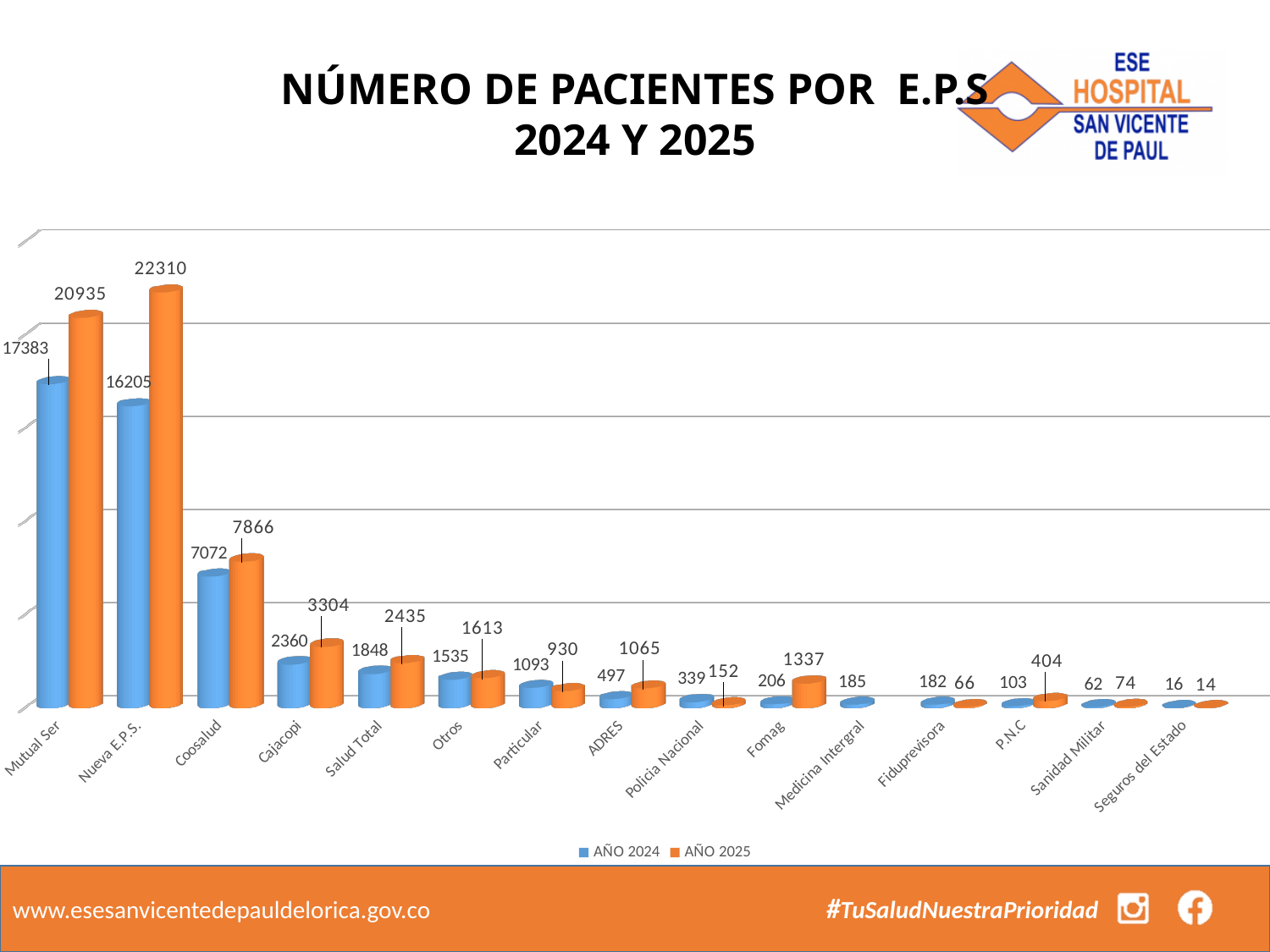
Which category has the highest value in the AÑO 2024 series? Mutual Ser What is the value for Nueva E.P.S. in the AÑO 2025 series? 22310 Which category has the lowest value in the AÑO 2025 series? Seguros del Estado What is the value for P.N.C in the AÑO 2025 series? 404 Which category has the highest value in the AÑO 2025 series? Nueva E.P.S. How many categories are shown on the x axis of the chart? 15 How many series does the legend list? 2 What is the difference between the AÑO 2025 and AÑO 2024 values for Nueva E.P.S.? 6105 What kind of chart is shown on the slide? Bar chart What is the difference between the AÑO 2025 and AÑO 2024 values for Coosalud? 794 What is the value for Mutual Ser in the AÑO 2024 series? 17383 For Fomag, which series has the larger value, AÑO 2024 or AÑO 2025? AÑO 2025